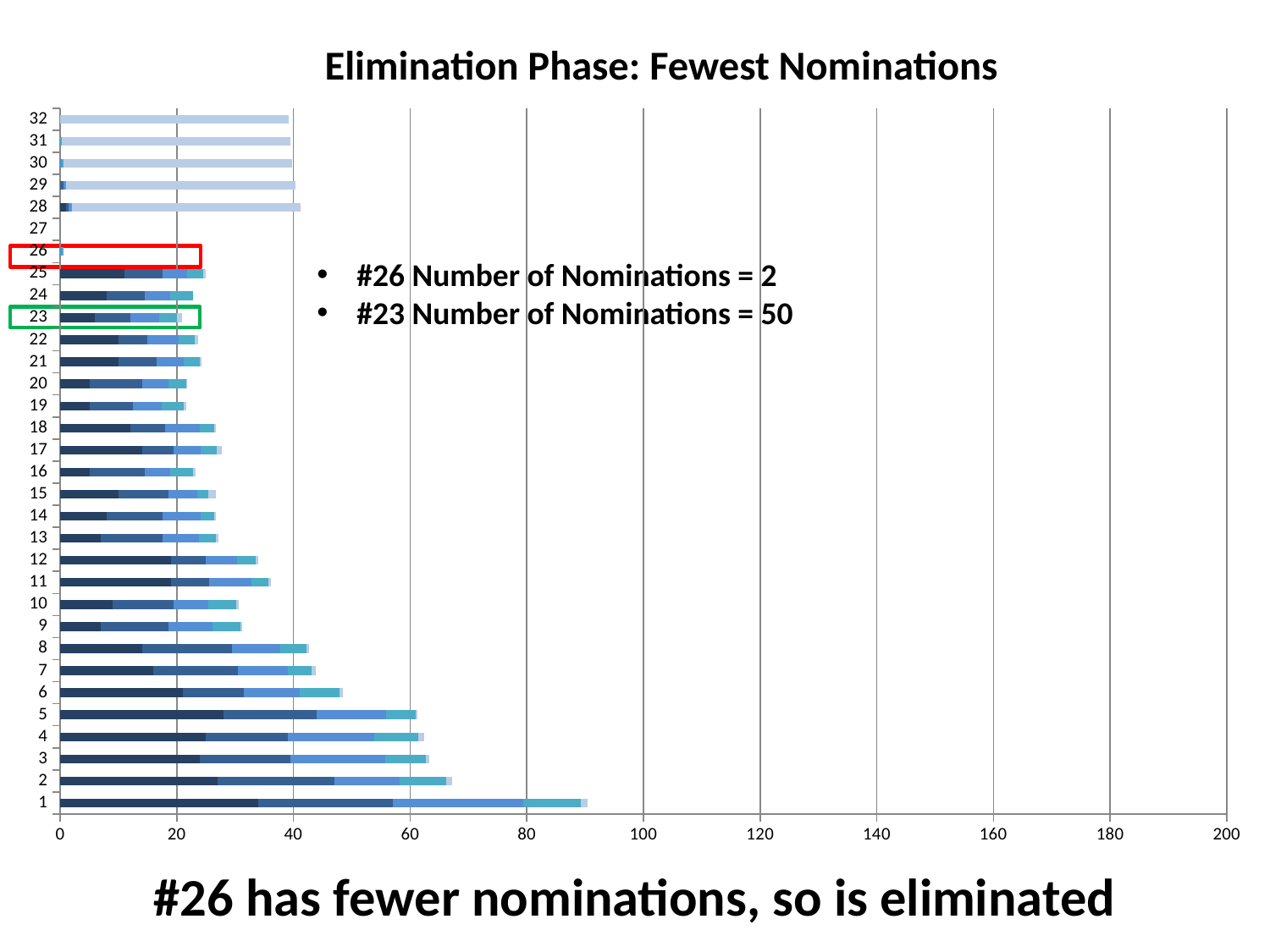
How many categories are listed on the vertical axis of the chart? 32 Which category on the chart is highlighted with a red box? 26 Is the total bar length for category 1 greater or less than 80? greater Is the total bar length for category 12 greater or less than 40? less What is the title of the chart on the slide? Elimination Phase: Fewest Nominations Which category has the longest bar in the chart? 1 Is the total bar length for category 1 greater or less than 100? less Which has the longer bar, category 28 or category 25? 28 Which has the longer bar, category 8 or category 12? 8 What kind of chart is shown on the slide? bar chart